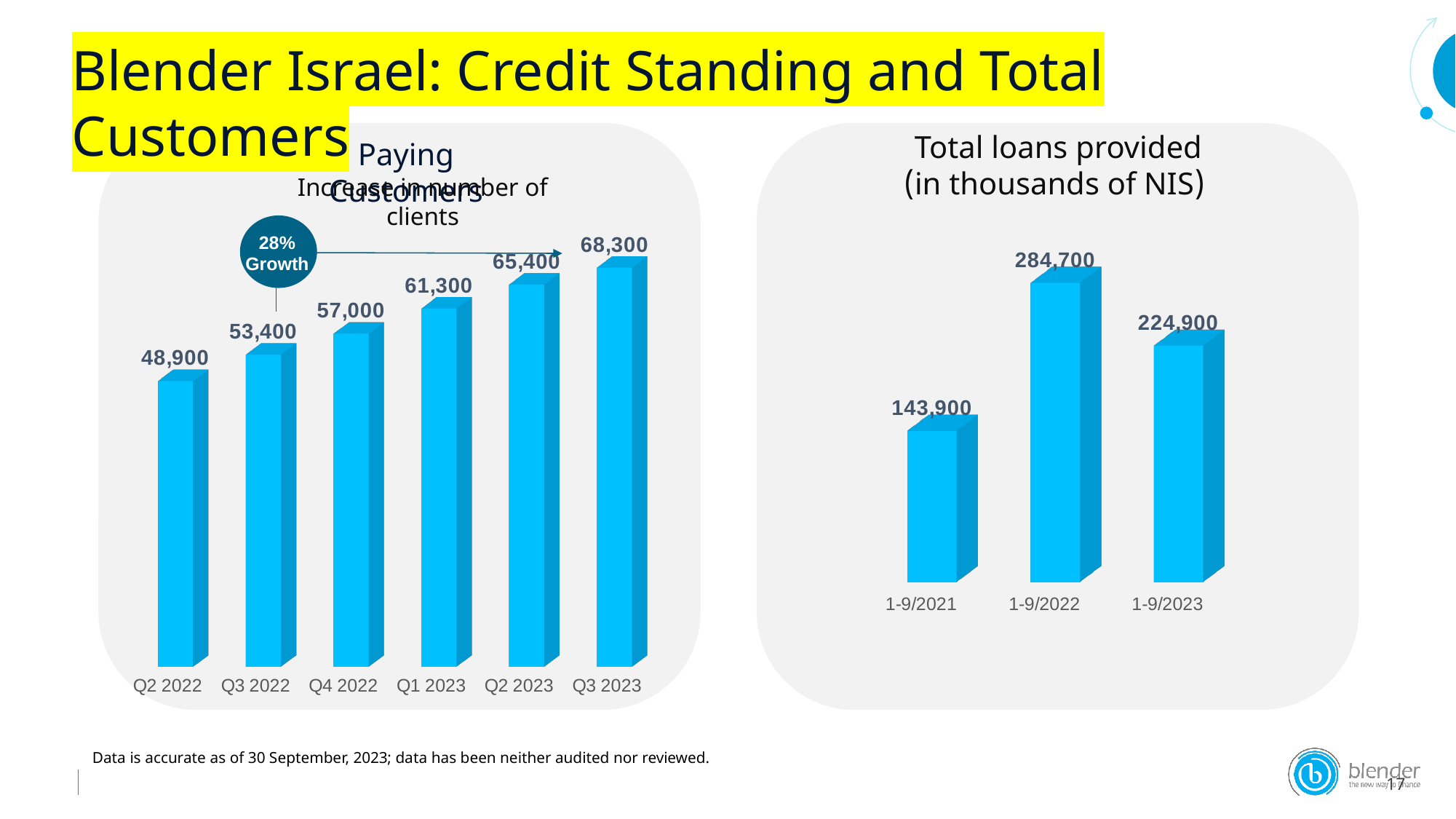
In the left chart (Paying Customers), what is the value for Q2 2022? 48,900 In the left chart (Paying Customers), do the values rise or fall from Q2 2022 to Q3 2023? rise How many quarters are shown in the left chart (Paying Customers)? 6 In the left chart (Paying Customers), which quarter has the lowest value? Q2 2022 In the right chart (Total loans provided), which period has the highest value? 1-9/2022 In the left chart (Paying Customers), what is the value for Q1 2023? 61,300 What type of chart is the right chart (Total loans provided)? bar chart In the left chart (Paying Customers), what is the value for Q3 2023? 68,300 In the right chart (Total loans provided), what is the value for 1-9/2021? 143,900 In the left chart (Paying Customers), what is the difference between Q3 2023 and Q2 2022? 19,400 In the right chart (Total loans provided), what is the difference between 1-9/2022 and 1-9/2023? 59,800 In the right chart (Total loans provided), what is the value for 1-9/2022? 284,700